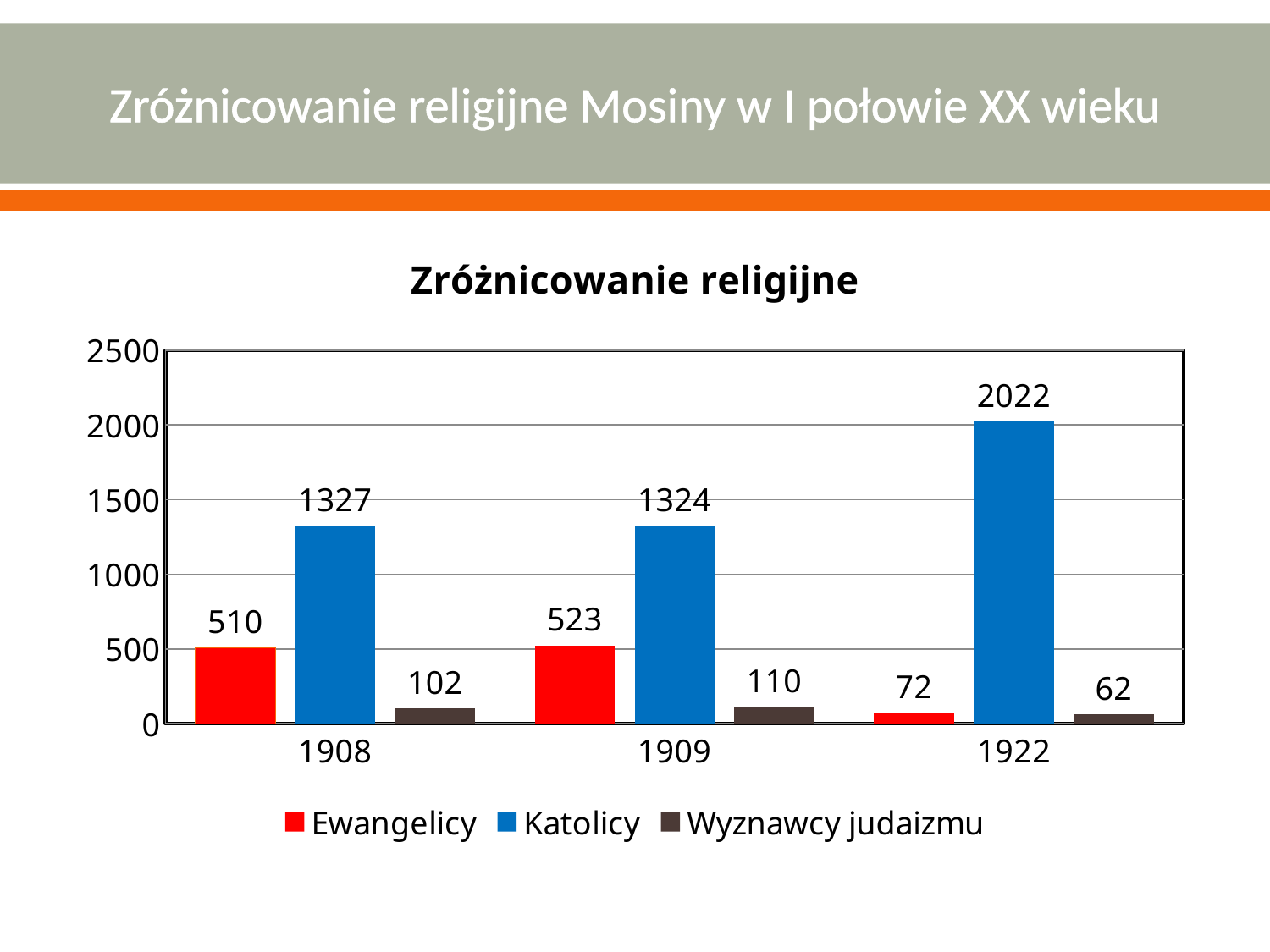
Does the Ewangelicy value rise or fall from 1909 to 1922? fall How many years are shown on the x axis? 3 Which is larger: Ewangelicy in 1909 or Ewangelicy in 1908? Ewangelicy in 1909 In which year is the Katolicy value highest? 1922 What is the title of the chart? Zróżnicowanie religijne How many series does the legend list? 3 What is the value for Wyznawcy judaizmu in 1909? 110 What is the value for Katolicy in 1922? 2022 In which year is the Ewangelicy value lowest? 1922 What kind of chart is shown? bar chart What is the value for Ewangelicy in 1908? 510 What is the difference between the Katolicy values in 1922 and 1908? 695